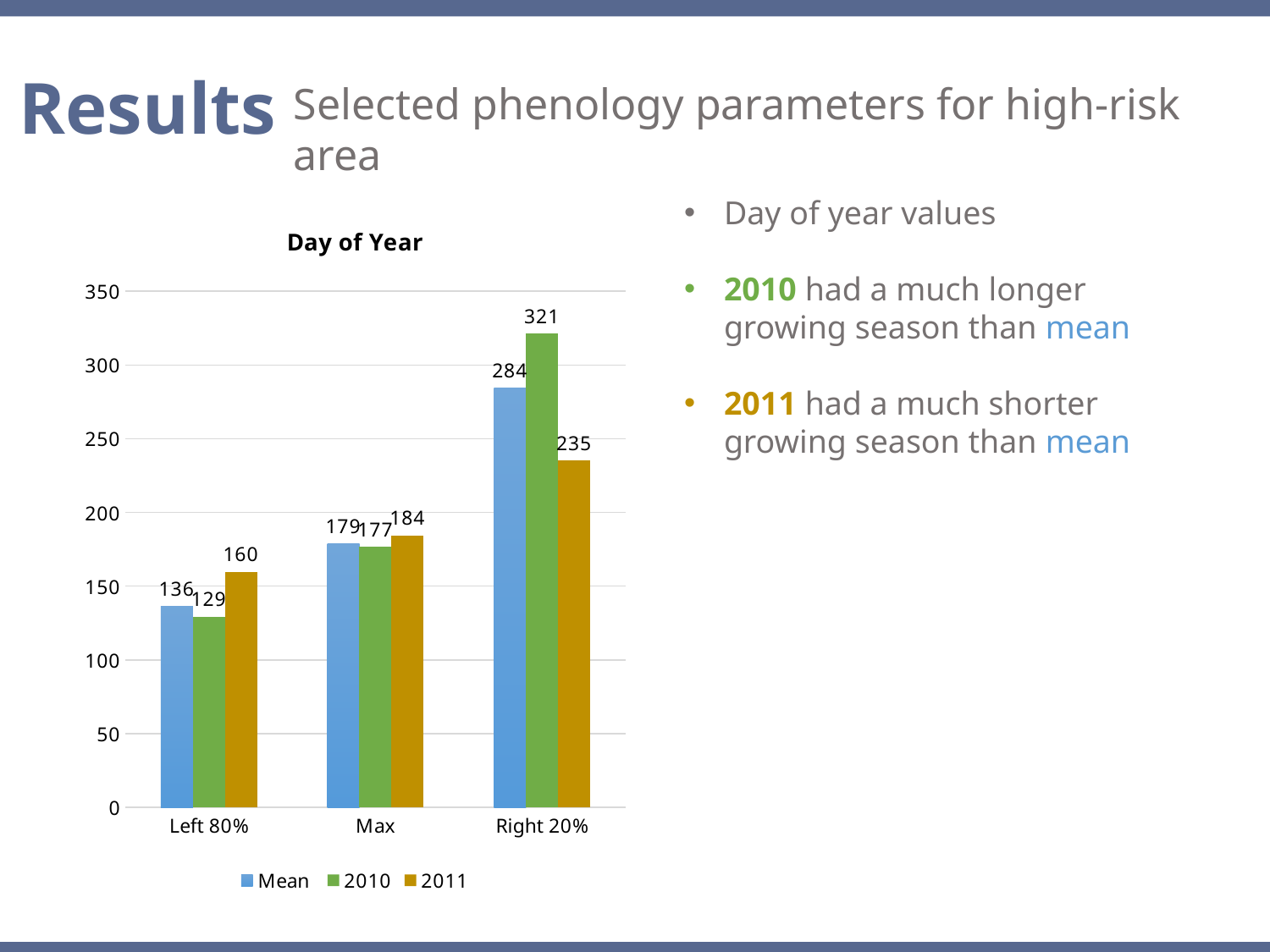
What is the title of the chart? Day of Year What is the 2011 value for Max? 184 What is the Mean value for Left 80%? 136 Which category has the highest 2011 value? Right 20% Is the Mean value for Right 20% greater or less than 250? greater How many series does the legend list? 3 What is the 2010 value for Right 20%? 321 What is the difference between the 2010 and 2011 values for Right 20%? 86 What kind of chart is shown? bar chart Which category has the lowest 2010 value? Left 80% How many categories are shown on the x axis? 3 For Left 80%, which is larger: the 2010 value or the 2011 value? 2011